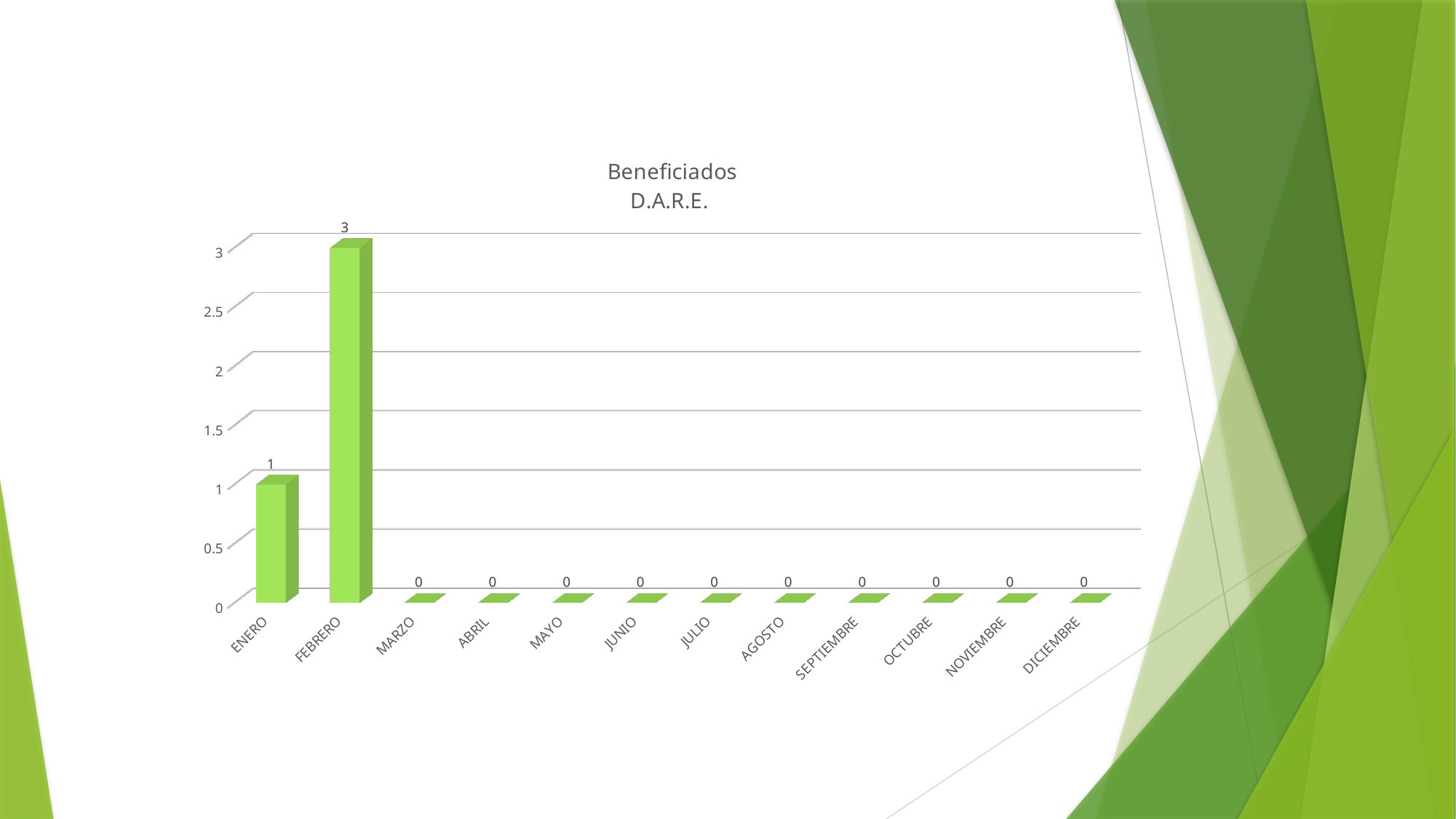
What is the value for FEBRERO? 3 What kind of chart is shown? bar chart What is the value for MARZO? 0 Which month has the highest value? FEBRERO What is the value for ENERO? 1 What is the value for DICIEMBRE? 0 Which is larger, the value for ENERO or the value for FEBRERO? FEBRERO How many months are shown on the x axis? 12 How many months have a value of 0? 10 What is the difference between the values for FEBRERO and ENERO? 2 What is the title of the chart? Beneficiados D.A.R.E. Is the value for FEBRERO greater or less than 2? greater